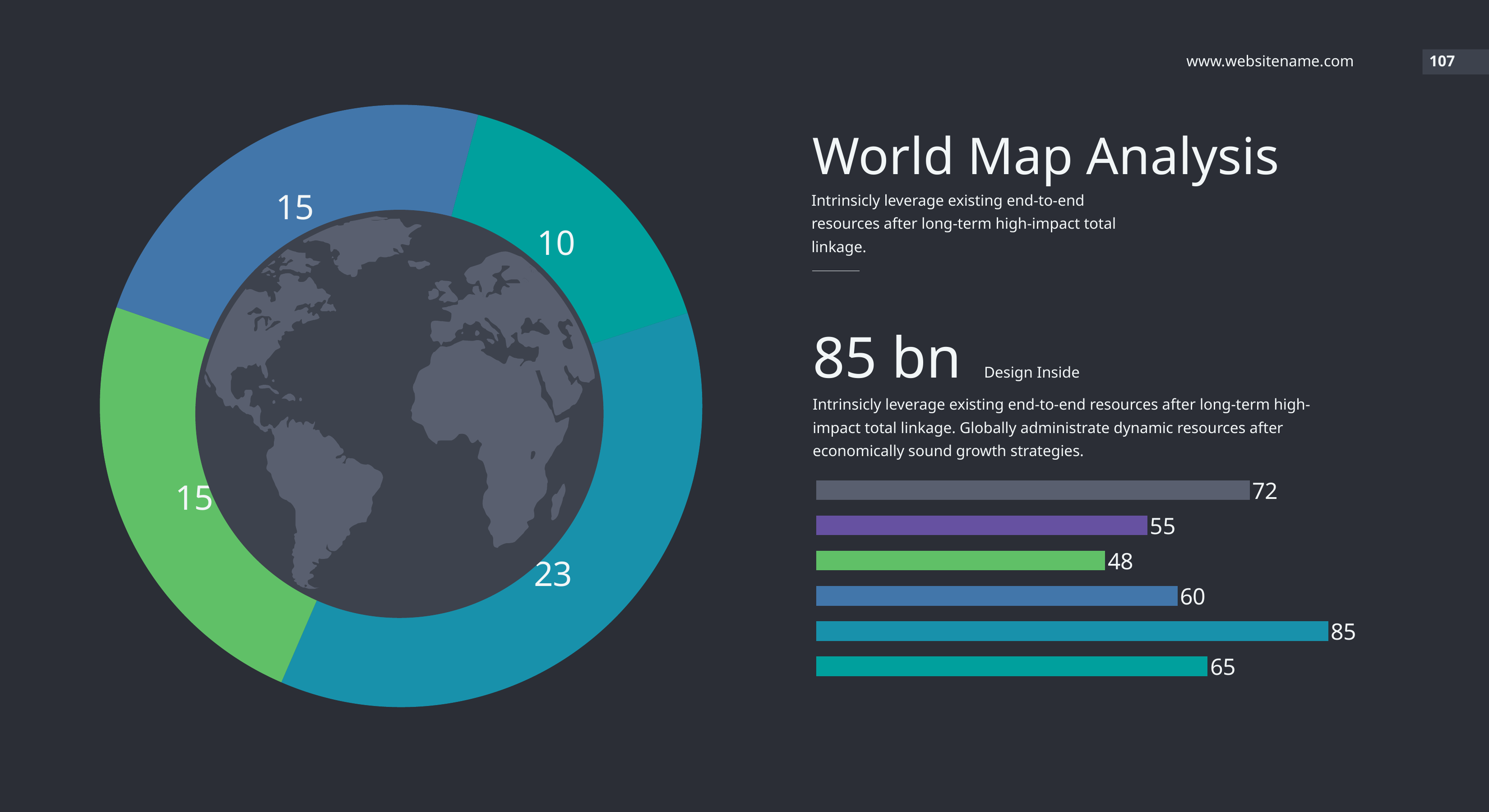
In the donut chart on the left, what is the value of the largest segment? 23 In the bar chart on the right, what is the value of the bottom bar? 65 In the bar chart on the right, what is the difference between the longest bar and the shortest bar? 37 In the bar chart on the right, what is the value of the purple bar? 55 How many bars are in the bar chart on the right? 6 In the bar chart on the right, what is the lowest value shown? 48 What kind of chart is shown on the right side of the slide? Bar chart In the donut chart on the left, what is the value of the smallest segment? 10 In the bar chart on the right, what is the value of the top (first) bar? 72 How many segments does the donut chart on the left have? 4 In the bar chart on the right, which is larger: the value of the blue bar or the value of the green bar? The blue bar (60) In the bar chart on the right, what is the highest value shown? 85